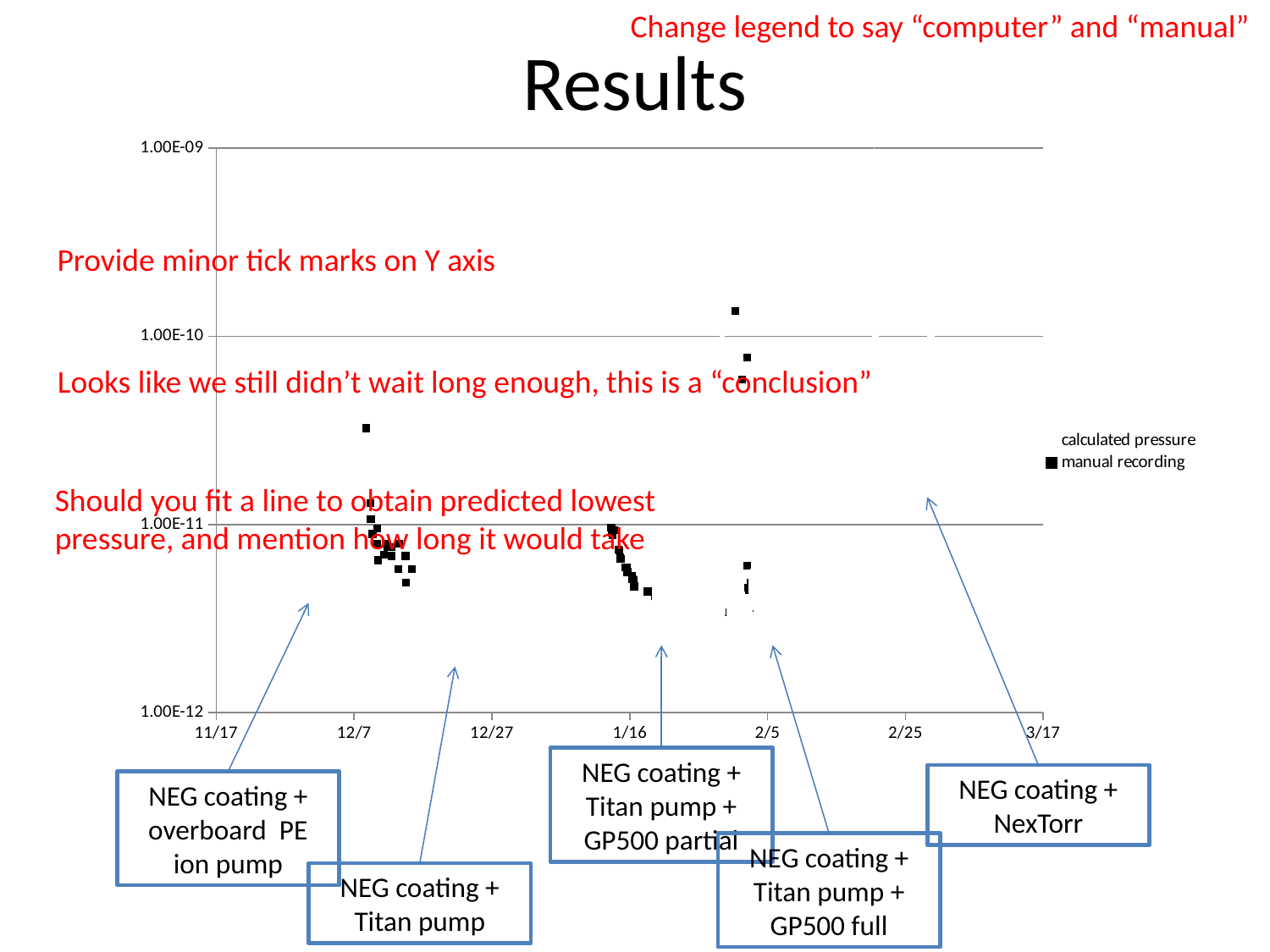
What is the lowest value labelled on the y axis of the chart? 1.00E-12 How many series does the chart legend list? 2 What kind of chart is shown on the slide? scatter chart Is the isolated point plotted shortly after 12/7 (above the main cluster) greater or less than 1.00E-10? less Is the highest plotted point on the chart (just before 2/5) greater or less than 1.00E-10? greater What are the two series names shown in the chart legend? calculated pressure and manual recording How many date labels are shown along the x axis of the chart? 7 What is the title of the slide containing the chart? Results What is the highest value labelled on the y axis of the chart? 1.00E-09 What is the first date label on the x axis of the chart? 11/17 What is the last date label on the x axis of the chart? 3/17 Are the points plotted just after 1/16 greater or less than 1.00E-10? less